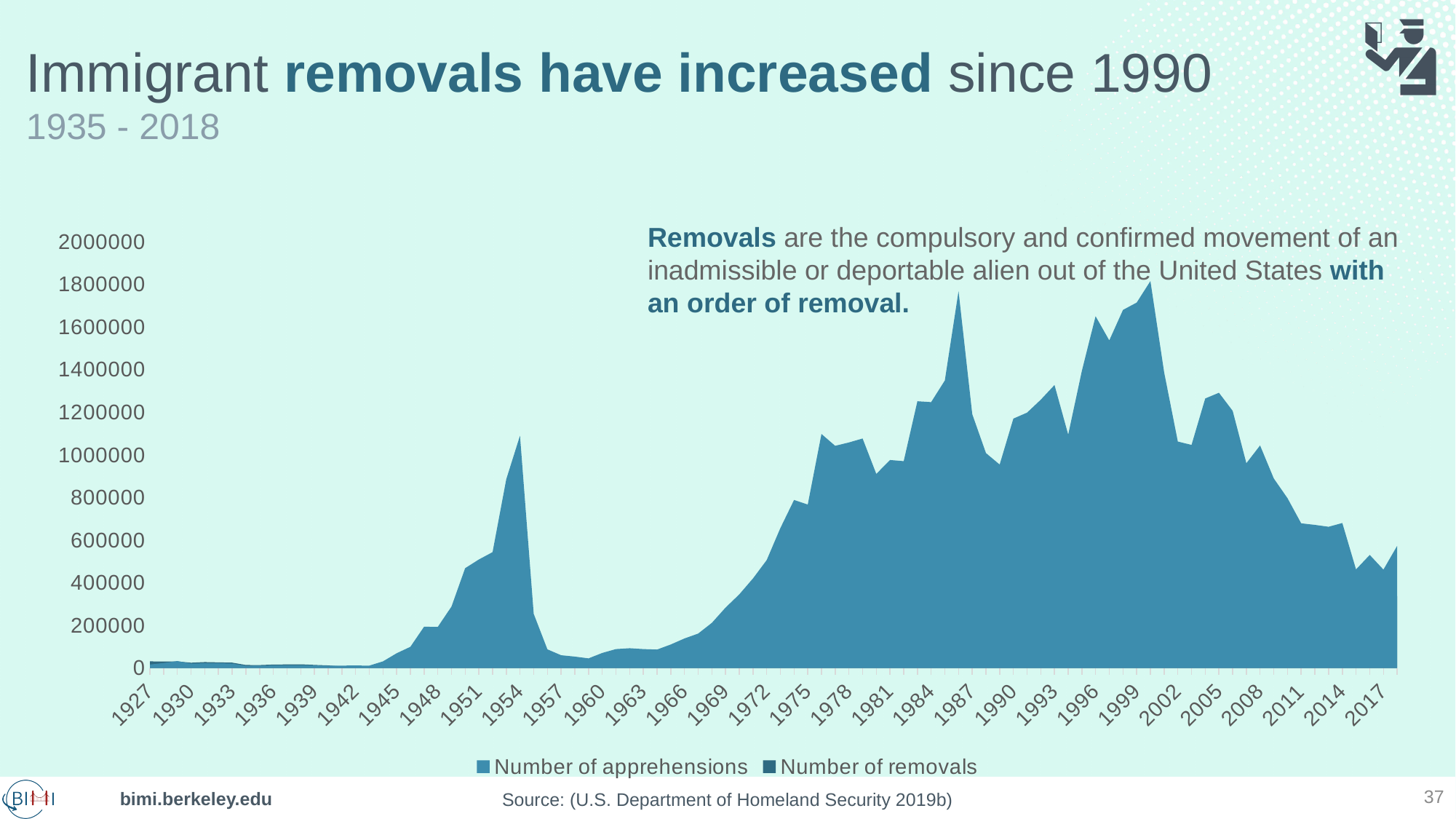
How many series does the chart legend list? 2 What kind of chart is shown on the slide? Area chart What is the highest value shown on the chart's vertical axis? 2000000 Do the values generally rise or fall between 1960 and 1986? rise Which year has the larger value, 1927 or 2017? 2017 What are the two series named in the chart legend? Number of apprehensions; Number of removals Is the value for 2017 greater or less than 800000? less Is the value for 1960 greater or less than 200000? less